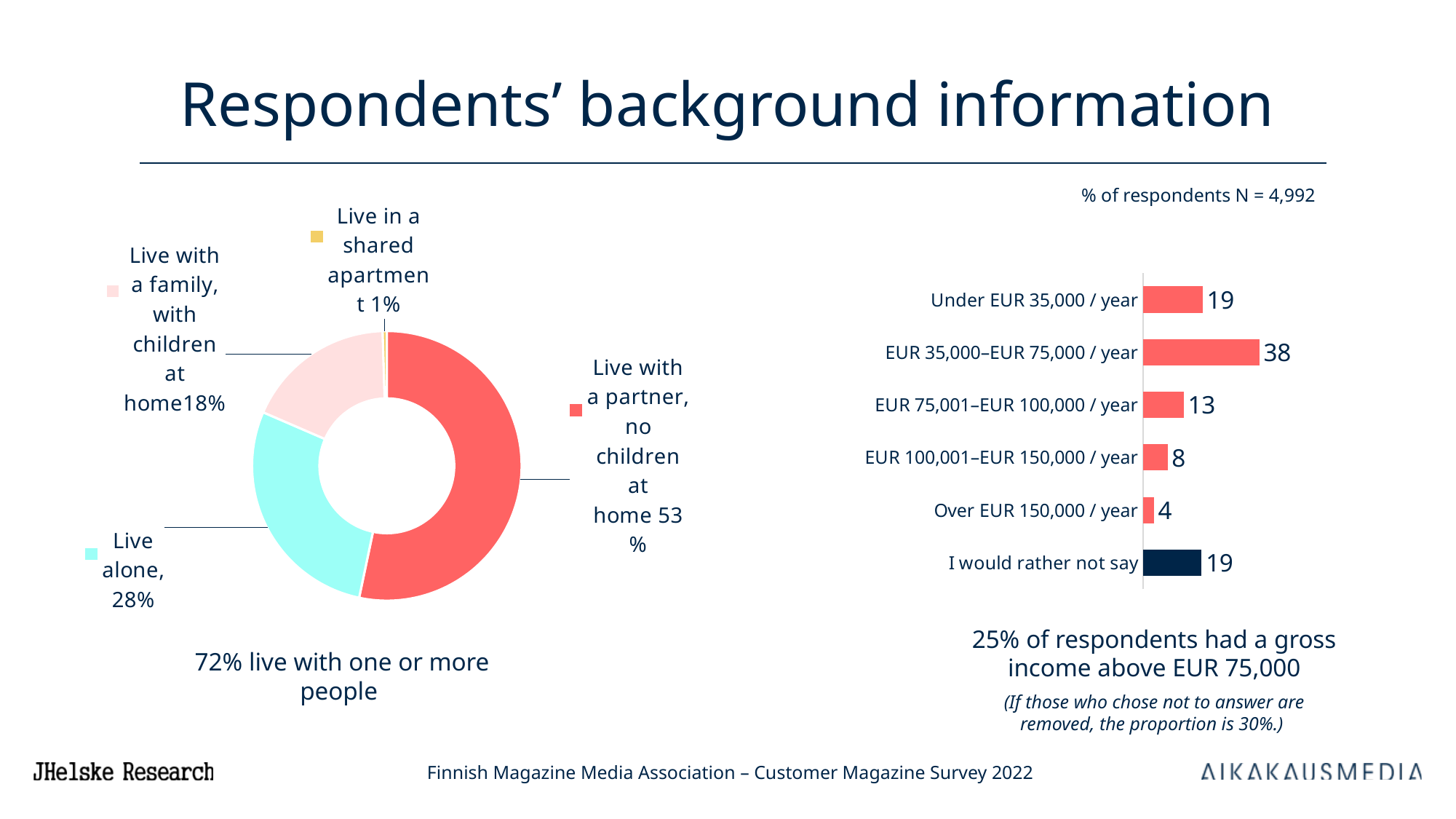
In the income bar chart on the right, what is the value for EUR 35,000–EUR 75,000 / year? 38 In the income bar chart on the right, what is the difference between the values for EUR 75,001–EUR 100,000 / year and EUR 100,001–EUR 150,000 / year? 5 What type of chart is shown on the right side of the slide? Bar chart In the income bar chart on the right, what is the value for Over EUR 150,000 / year? 4 In the income bar chart on the right, which category has the lowest value? Over EUR 150,000 / year In the income bar chart on the right, which is larger: the value for Under EUR 35,000 / year or the value for EUR 75,001–EUR 100,000 / year? Under EUR 35,000 / year In the donut chart on the left, what is the difference in percentage points between those who live alone and those who live with a family with children at home? 10 In the donut chart on the left, which living arrangement has the smallest share? Live in a shared apartment In the donut chart on the left, what percentage of respondents live with a partner with no children at home? 53% In the income bar chart on the right, which category has the highest value? EUR 35,000–EUR 75,000 / year In the donut chart on the left, what percentage of respondents live alone? 28% In the donut chart on the left, how many categories are shown? 4